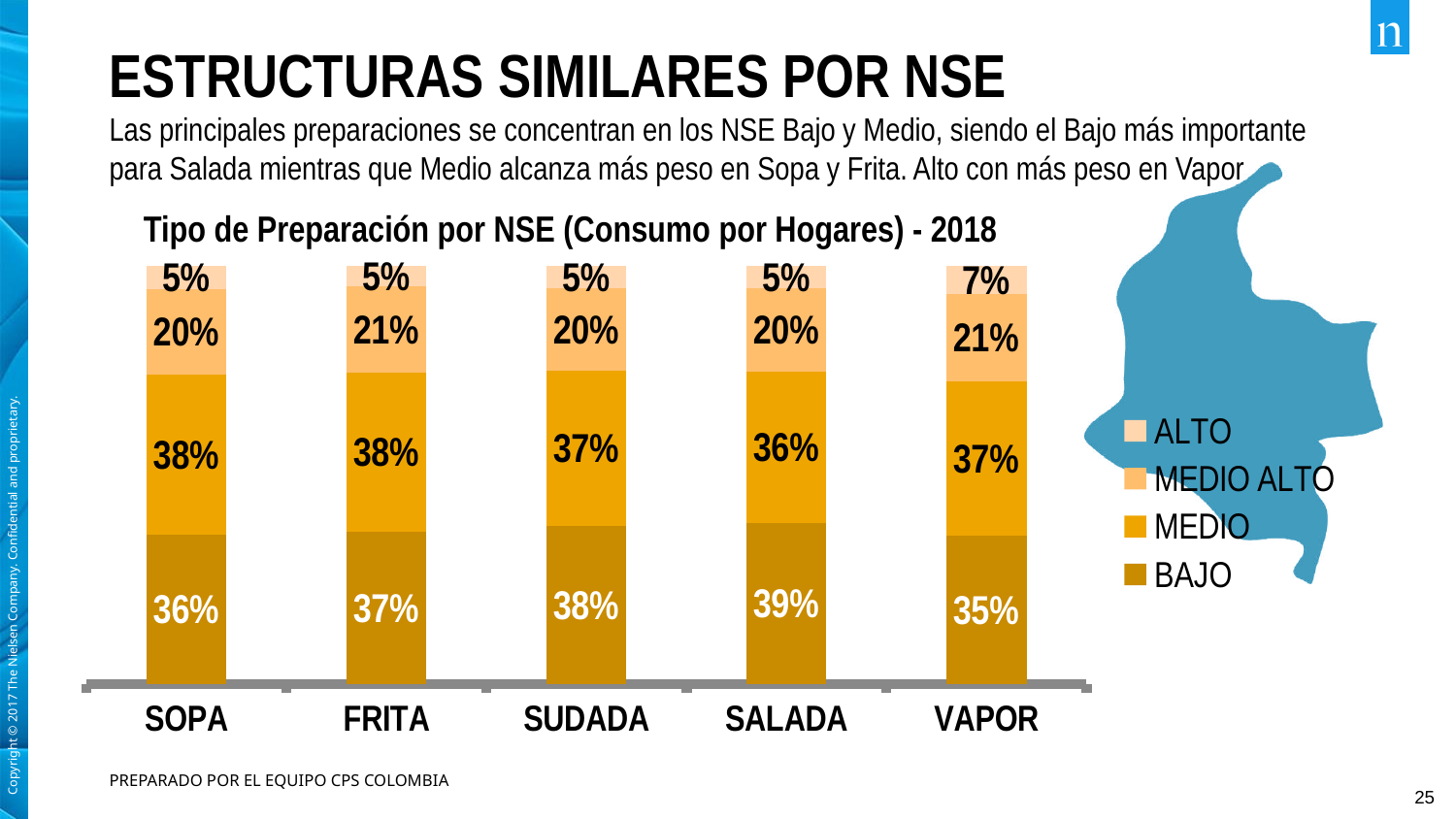
What is the BAJO value for SALADA? 39% What is the total of the stacked bar for SUDADA? 100% What is the difference between the BAJO value for SALADA and the BAJO value for VAPOR? 4% What is the title of the chart? Tipo de Preparación por NSE (Consumo por Hogares) - 2018 Which is larger, the MEDIO value for SOPA or the MEDIO value for SALADA? SOPA How many series does the chart legend list? 4 What is the ALTO value for VAPOR? 7% Which category has the highest BAJO value? SALADA What type of chart is shown on the slide? Stacked bar chart Which category has the lowest BAJO value? VAPOR How many categories are shown on the x axis of the chart? 5 What is the MEDIO ALTO value for FRITA? 21%